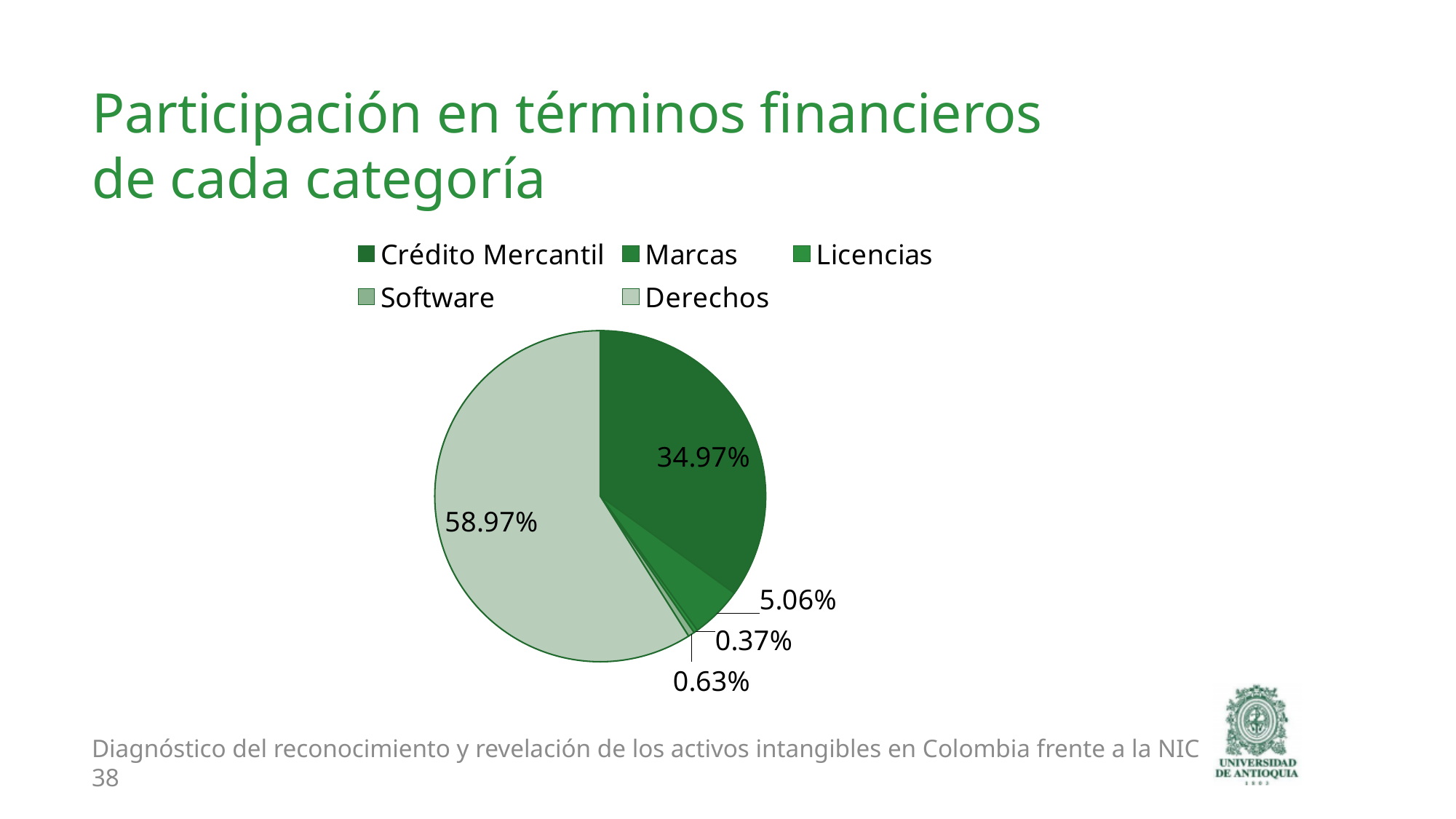
Which category has the smallest slice of the pie? Licencias What is the value shown for Software? 0.63% Which category has the largest slice of the pie? Derechos Which is larger, the share for Software or the share for Licencias? Software What is the combined share of Crédito Mercantil and Marcas? 40.03% What is the difference between the shares of Derechos and Crédito Mercantil? 24.00% What is the value shown for Licencias? 0.37% What share of the pie does Derechos hold? 58.97% What is the value shown for Marcas? 5.06% What kind of chart is shown on the slide? pie chart What share of the pie does Crédito Mercantil hold? 34.97% How many categories does the legend list? 5